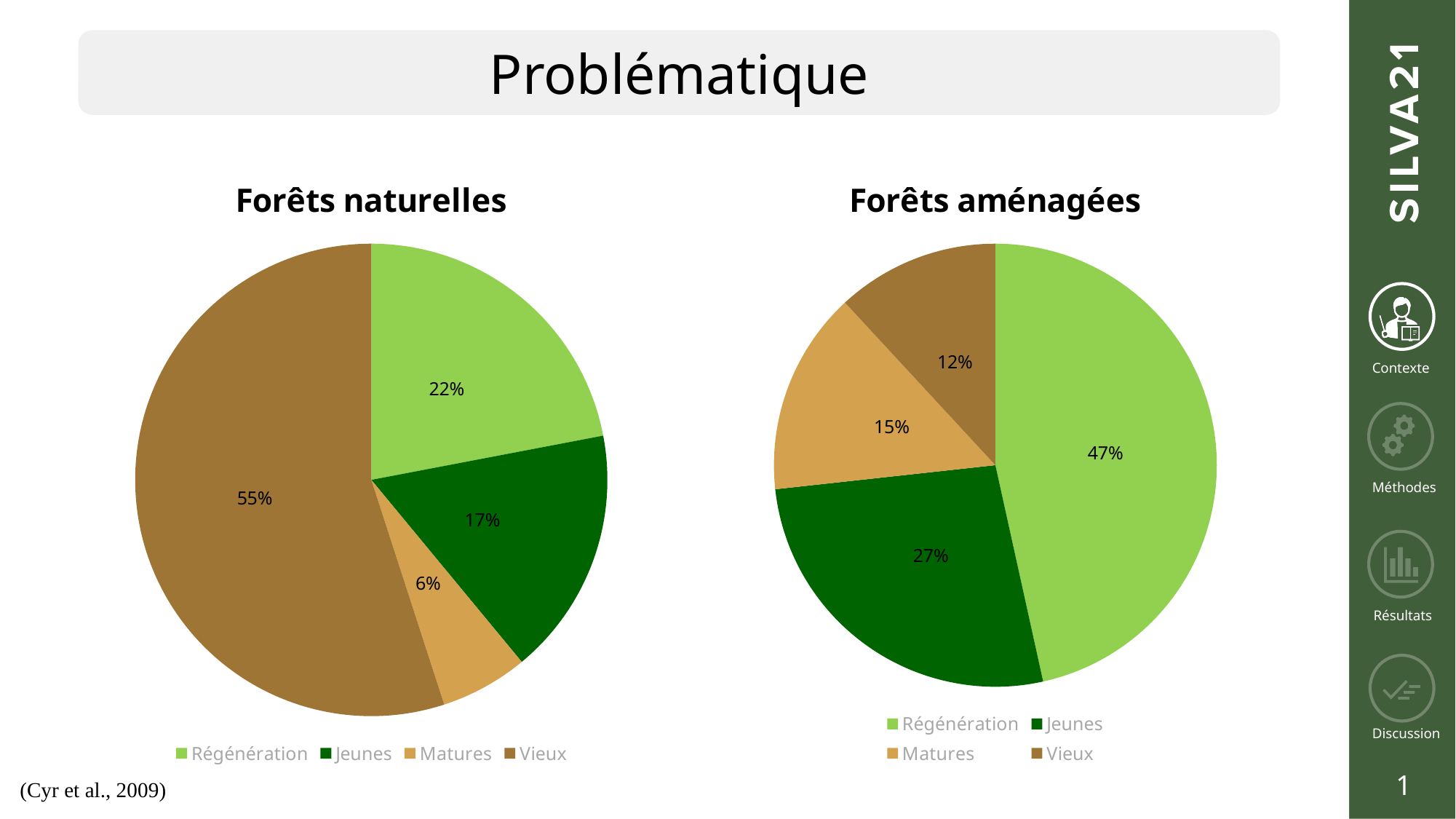
What is the title of the chart on the left of the slide? Forêts naturelles In the 'Forêts aménagées' pie chart, which category has the smallest slice? Vieux In the 'Forêts naturelles' pie chart, what share does Vieux have? 55% In the 'Forêts naturelles' pie chart, which category has the largest slice? Vieux How many slices does the 'Forêts naturelles' pie chart have? 4 What kind of chart is 'Forêts aménagées'? Pie chart In the 'Forêts aménagées' pie chart, what is the difference between Régénération and Matures? 32% In the 'Forêts aménagées' pie chart, what is the value for Jeunes? 27% In the 'Forêts aménagées' pie chart, what share does Régénération have? 47% In the 'Forêts aménagées' pie chart, which is larger, Matures or Vieux? Matures In the 'Forêts naturelles' pie chart, what is the difference between Régénération and Jeunes? 5% In the 'Forêts naturelles' pie chart, what is the value for Matures? 6%